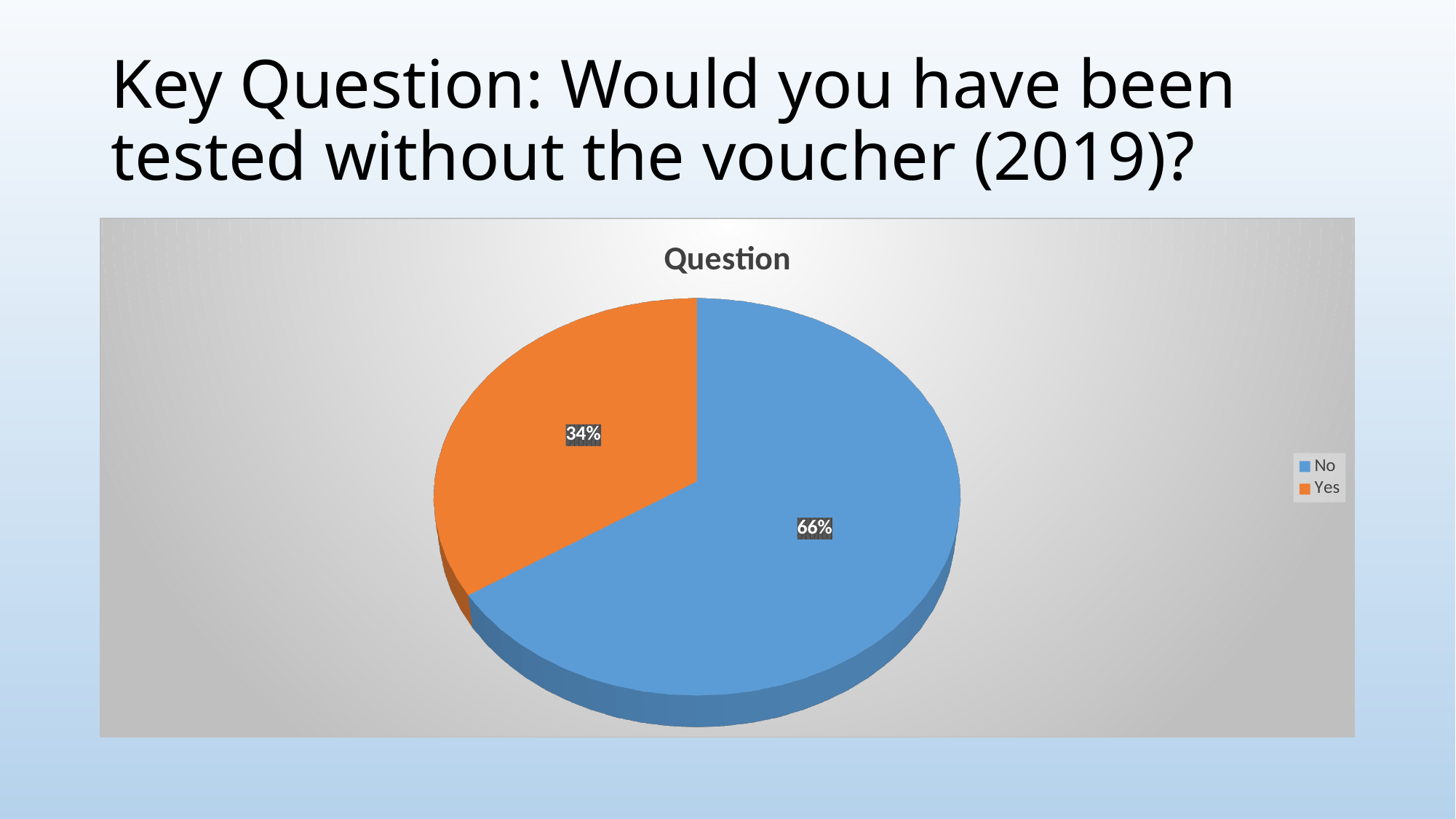
What is the title of the chart? Question What colour is the "Yes" slice in the pie chart? Orange What kind of chart is shown on the slide? Pie chart Which category has the largest share of the pie chart? No Which slice is larger, "No" or "Yes"? No What percentage of the pie chart is labelled "No"? 66% How many slices does the pie chart have? 2 How many entries does the legend list? 2 Which category has the smallest share of the pie chart? Yes What share of the pie does the "Yes" slice represent? 34% What percentage of the pie chart is labelled "Yes"? 34% What is the difference in percentage points between the "No" and "Yes" slices? 32